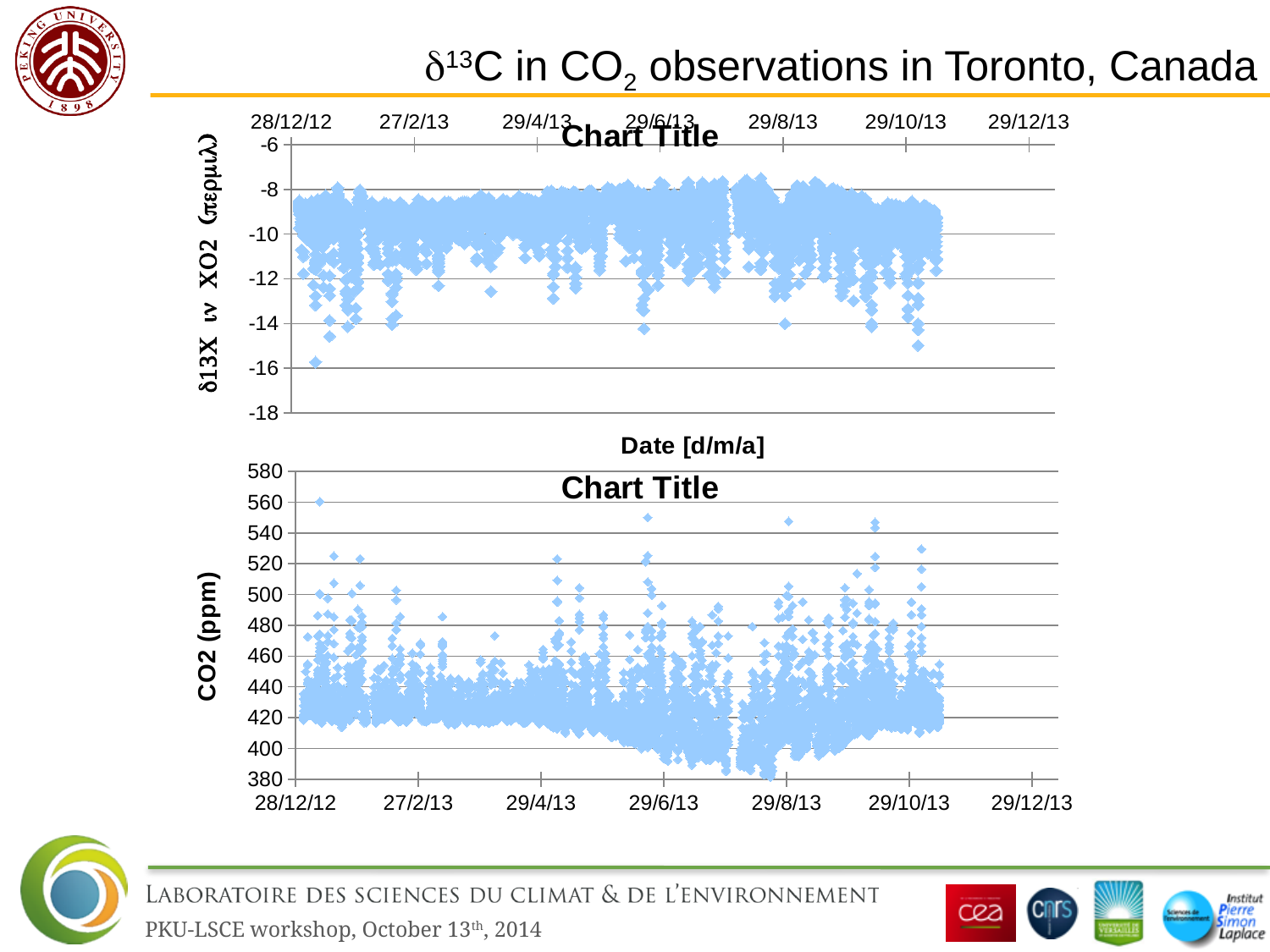
What is the x-axis label shown between the two charts? Date [d/m/a] What is the lowest value shown on the y-axis of the top chart? -18 In the top chart, is the lowest δ13C value plotted greater or less than -14? less In the bottom chart, is the highest CO2 value plotted greater or less than 540? greater In the top chart, is the highest δ13C value plotted greater or less than -8? greater What kind of chart is the top chart on the slide? scatter chart What kind of chart is the bottom chart on the slide? scatter chart What is the highest value shown on the y-axis of the bottom chart? 580